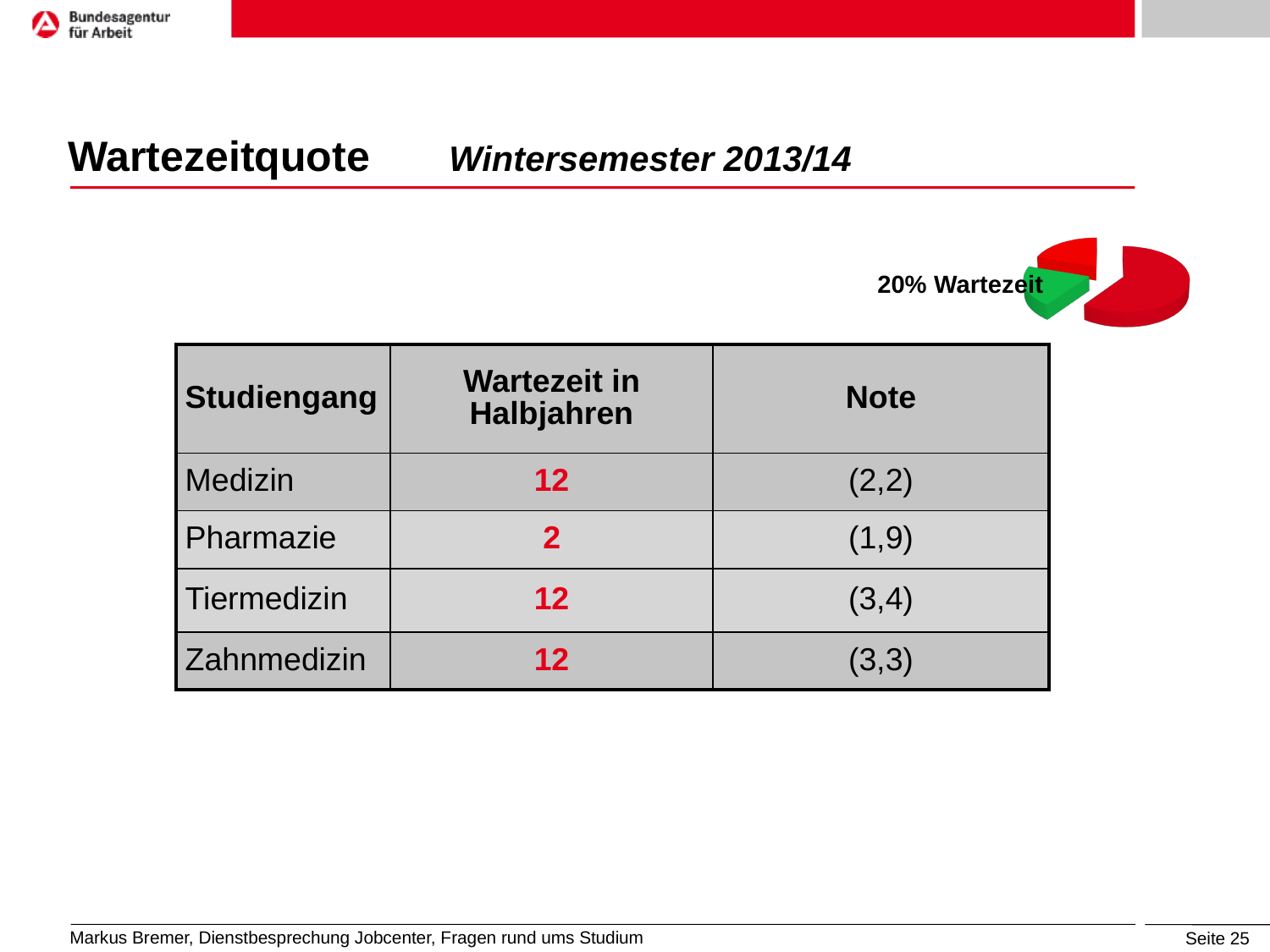
What share of the pie does the green slice labelled Wartezeit represent? 20% What kind of chart is shown on the slide? pie chart How many slices does the pie chart have? 3 What is the label attached to the green slice of the pie chart? 20% Wartezeit Which is larger in the pie chart, the green Wartezeit slice or the large red slice? the large red slice Is the share of the Wartezeit slice greater or less than 50%? less What colour is the largest slice of the pie chart? red What colour is the slice labelled 20% Wartezeit? green